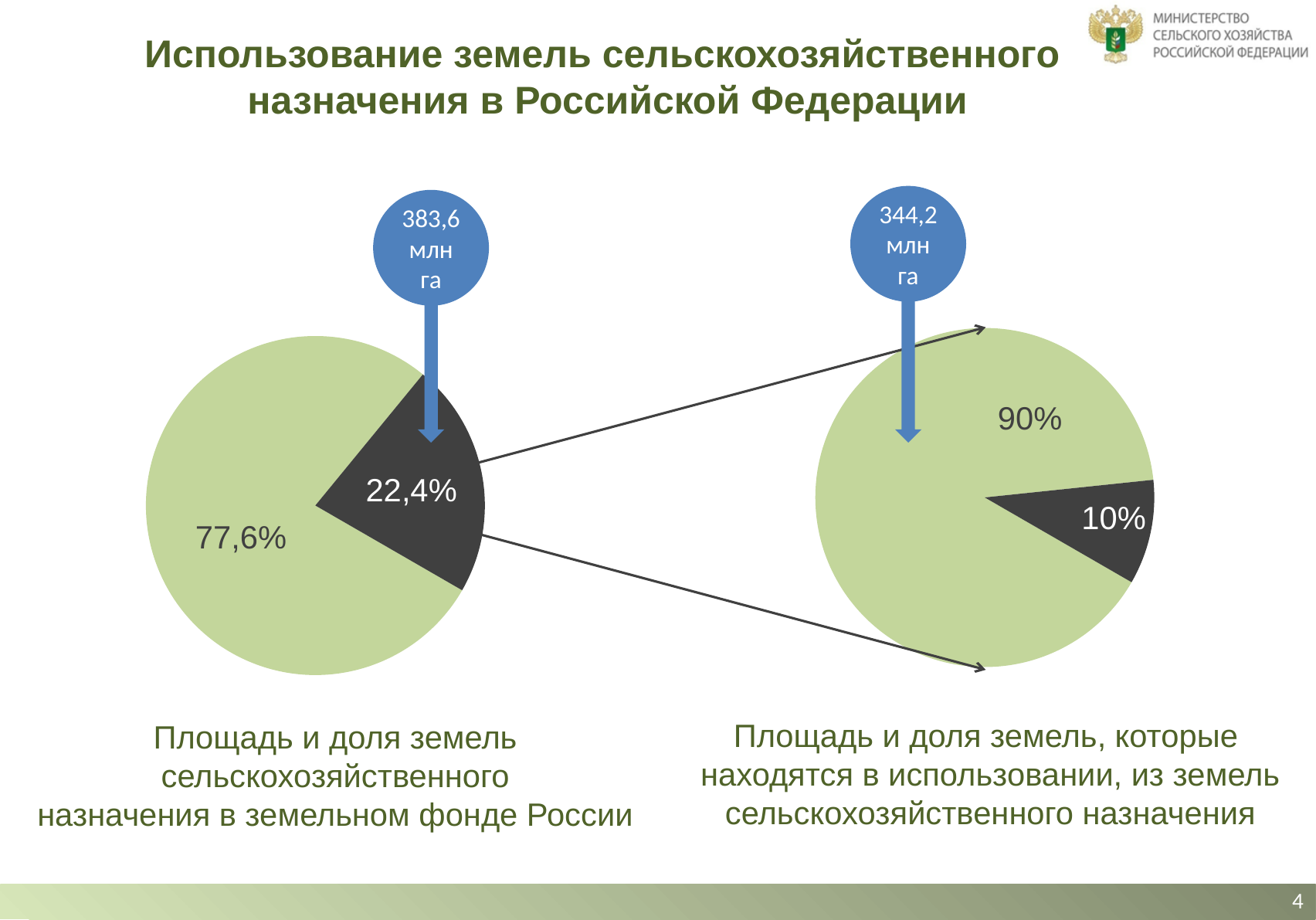
In the left pie chart, which slice is larger, the green one or the dark one? the green one What area in million hectares is labelled above the right pie chart? 344,2 млн га What is the difference between the two shares in the right pie chart? 80% In the right pie chart, what share is shown for the green slice? 90% How many slices does the right pie chart have? 2 What area in million hectares is labelled above the left pie chart? 383,6 млн га How many slices does the left pie chart have? 2 In the right pie chart, what share is shown for the dark slice? 10% What is the difference between the two shares in the left pie chart? 55,2% In the left pie chart, what share is shown for the green slice? 77,6% What type of chart is shown on the left side of the slide? pie chart In the left pie chart, what share is shown for the dark slice? 22,4%